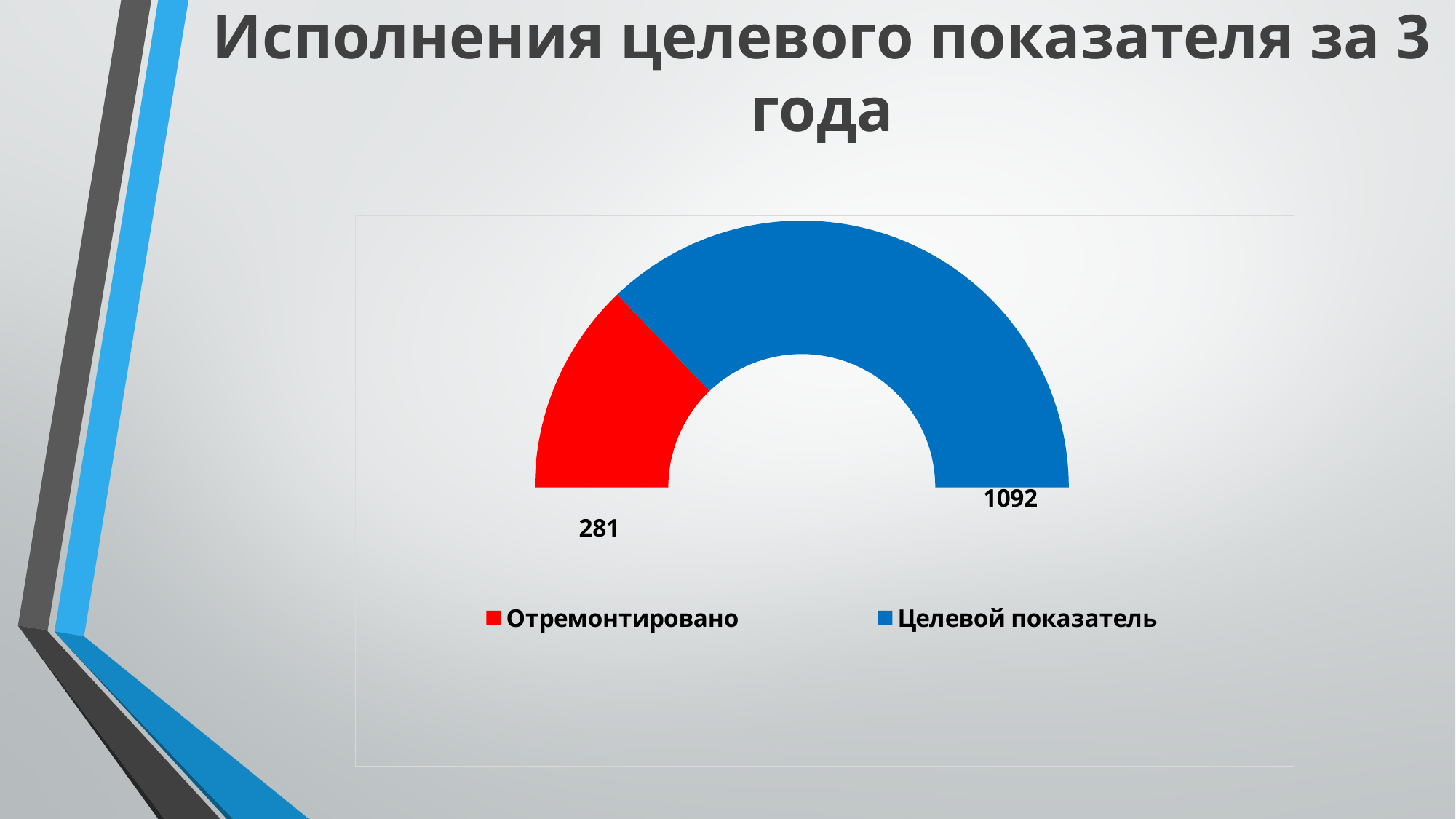
What is the title of the slide? Исполнения целевого показателя за 3 года Which category has the highest value? Целевой показатель Which is larger, Отремонтировано or Целевой показатель? Целевой показатель Which category has the lowest value? Отремонтировано What kind of chart is shown on the slide? Doughnut chart What is the value for Целевой показатель? 1092 What is the difference between the values for Целевой показатель and Отремонтировано? 811 What colour represents Отремонтировано in the chart? Red How many entries does the legend list? 2 How many categories are shown in the chart? 2 What is the value for Отремонтировано? 281